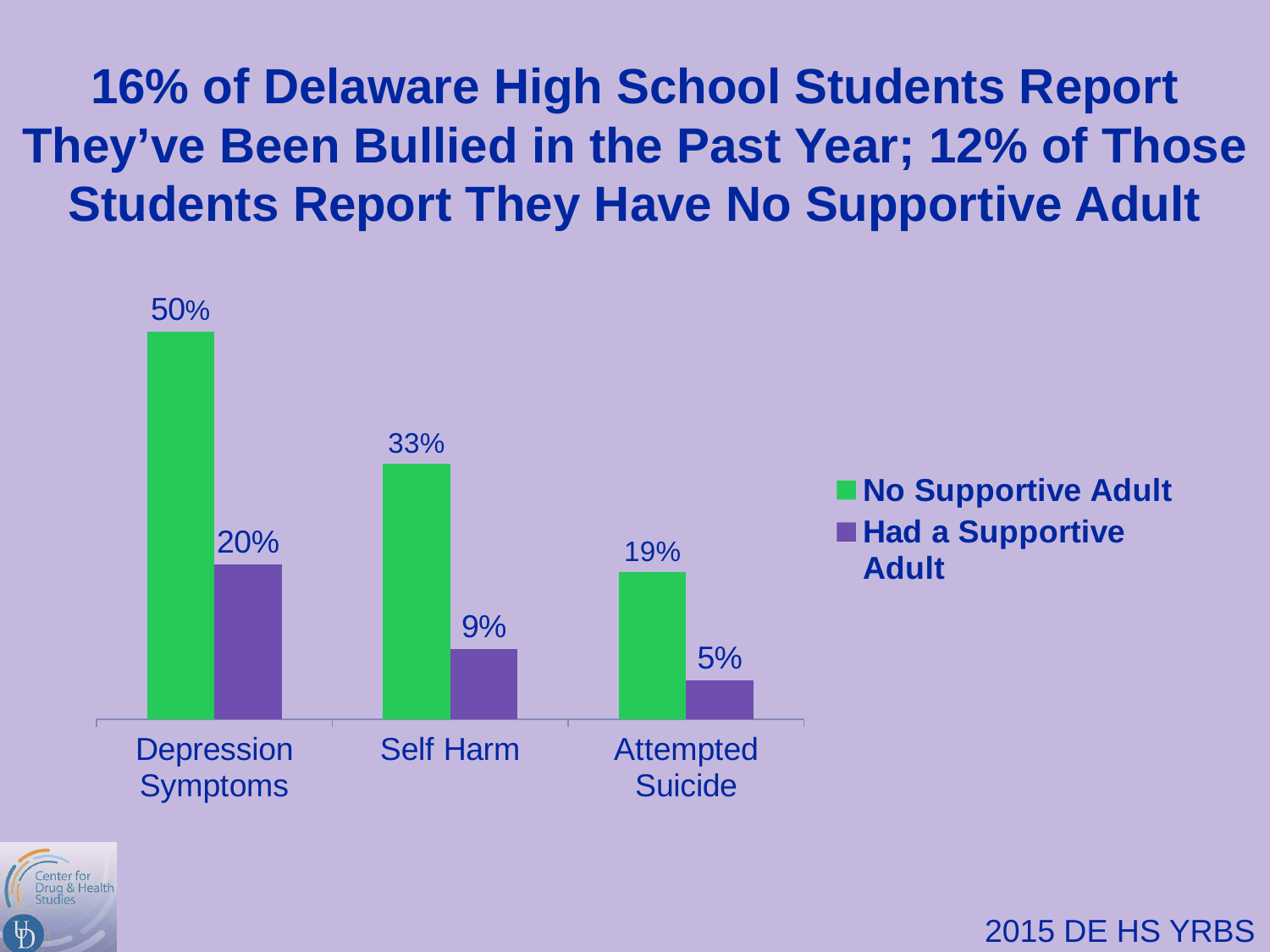
Which category has the highest value for the No Supportive Adult series? Depression Symptoms How many categories are shown on the x axis? 3 What is the difference between the No Supportive Adult and Had a Supportive Adult values for Depression Symptoms? 30% What is the value for Self Harm among students who had a supportive adult? 9% Which category has the lowest value for the Had a Supportive Adult series? Attempted Suicide What is the value for Attempted Suicide in the No Supportive Adult series? 19% What percentage of bullied students with no supportive adult report depression symptoms? 50% How many series does the legend list? 2 Which colour represents the No Supportive Adult series? Green Which is larger: the Had a Supportive Adult value for Depression Symptoms or the No Supportive Adult value for Attempted Suicide? Had a Supportive Adult value for Depression Symptoms What is the difference between the No Supportive Adult and Had a Supportive Adult values for Self Harm? 24% What kind of chart is shown on the slide? Bar chart